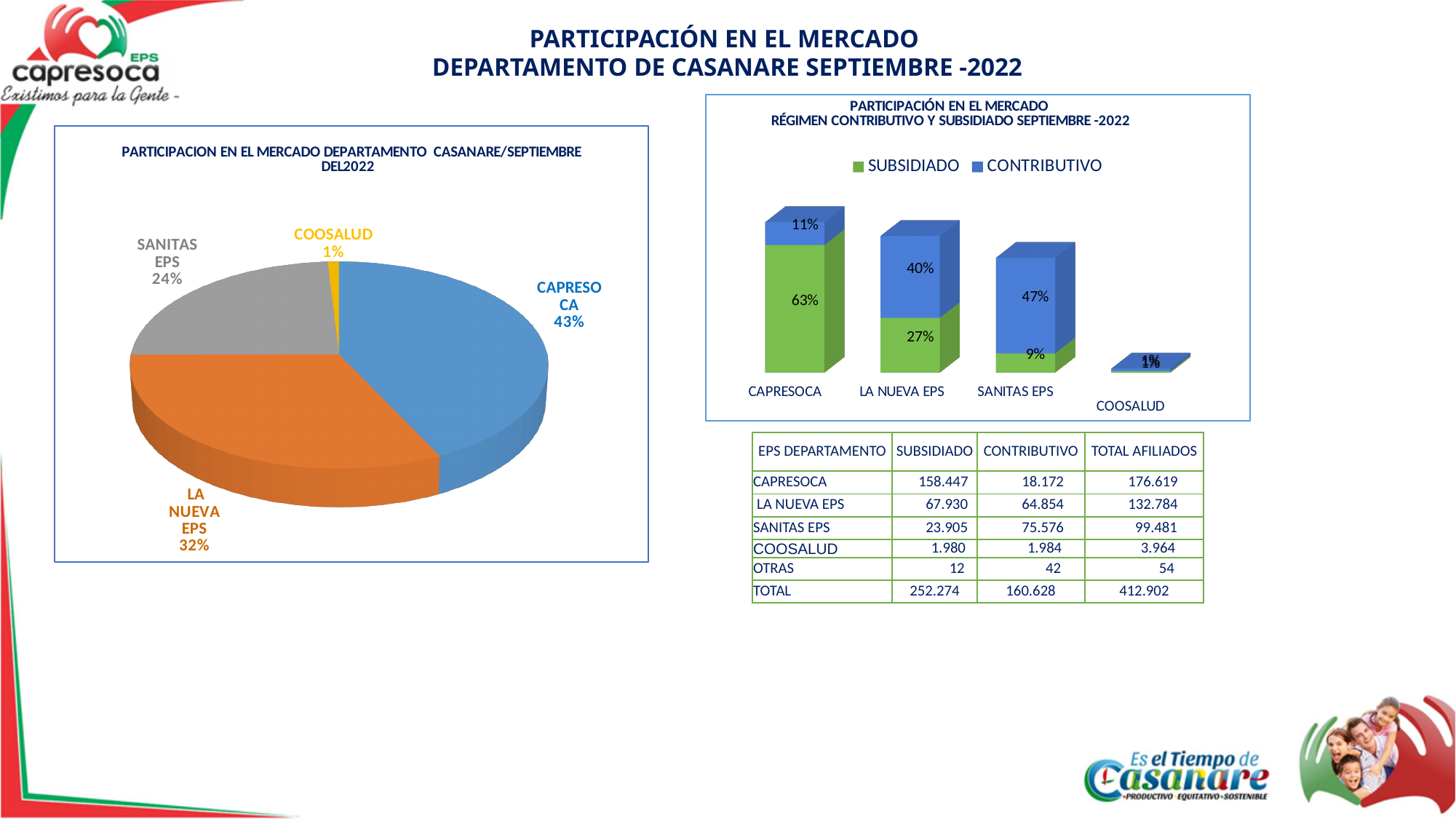
In the pie chart on the left, which EPS has the largest share? CAPRESOCA How many series does the legend of the bar chart on the right list? 2 In the bar chart on the right, which is larger for LA NUEVA EPS: SUBSIDIADO or CONTRIBUTIVO? CONTRIBUTIVO In the bar chart on the right, what is the total of the stacked bar for LA NUEVA EPS? 67% In the pie chart on the left, which EPS has the smallest share? COOSALUD In the pie chart on the left, what share does CAPRESOCA hold? 43% In the pie chart on the left, how many slices are there? 4 In the bar chart on the right, what is the CONTRIBUTIVO value for SANITAS EPS? 47% In the pie chart on the left, how many percentage points larger is CAPRESOCA's share than LA NUEVA EPS's share? 11% In the bar chart on the right, what is the SUBSIDIADO value for CAPRESOCA? 63% What type of chart is the chart on the left? Pie chart In the pie chart on the left, what share does SANITAS EPS hold? 24%